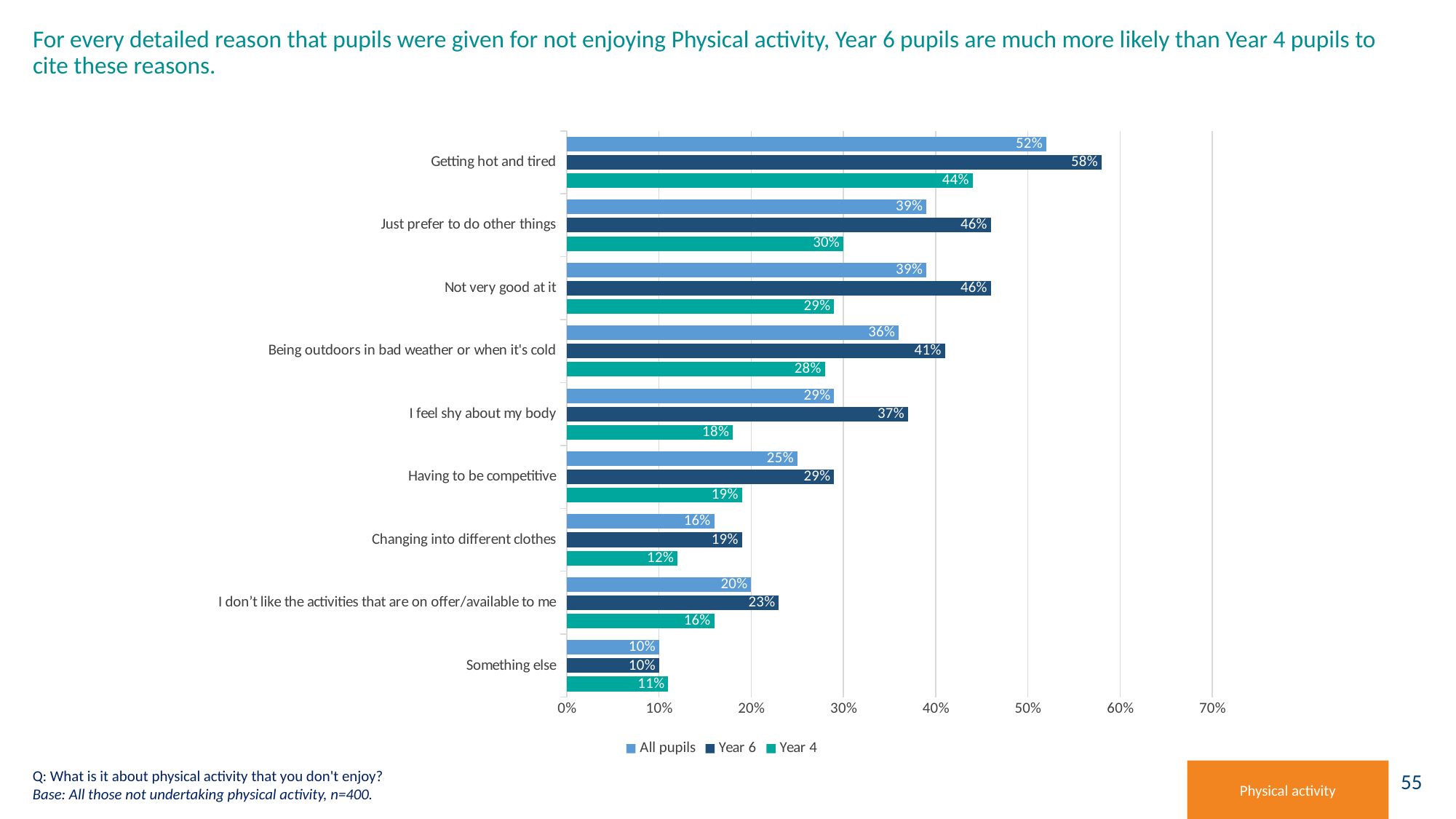
Is the Year 6 value for 'Being outdoors in bad weather or when it's cold' greater or less than 40%? greater How many reasons (categories) are shown on the chart? 9 What kind of chart is shown on the slide? Bar chart Which reason has the highest value for Year 6 pupils? Getting hot and tired How many series does the legend list? 3 Which is larger for 'Something else': the Year 4 value or the Year 6 value? Year 4 What is the difference between the Year 6 and Year 4 values for 'Just prefer to do other things'? 16 percentage points What percentage of Year 6 pupils cited 'Getting hot and tired' as a reason for not enjoying physical activity? 58% What is the value for All pupils for 'Having to be competitive'? 25% What is the value for Year 4 pupils for 'I feel shy about my body'? 18% What are the three series listed in the legend? All pupils, Year 6, Year 4 Which reason has the lowest value for All pupils? Something else